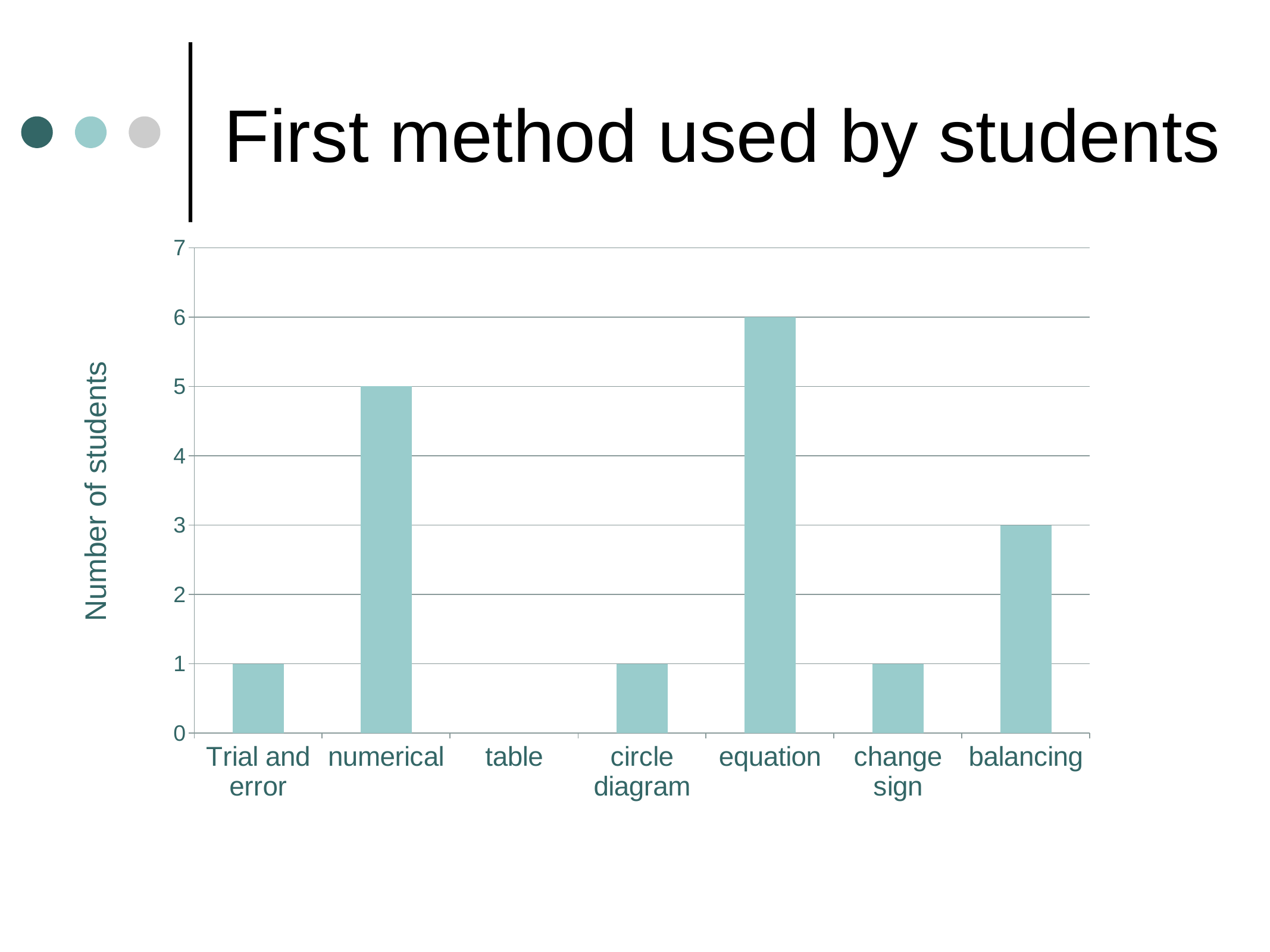
What is the label of the vertical axis? Number of students What is the title of the slide containing the chart? First method used by students What is the number of students for table? 0 How many categories are shown on the x axis of the chart? 7 What kind of chart is shown on the slide? bar chart Which method has the lowest number of students? table What is the number of students for numerical? 5 What is the number of students for balancing? 3 Which method has the highest number of students? equation What is the difference in number of students between equation and numerical? 1 What is the number of students for equation? 6 Which has more students, balancing or circle diagram? balancing